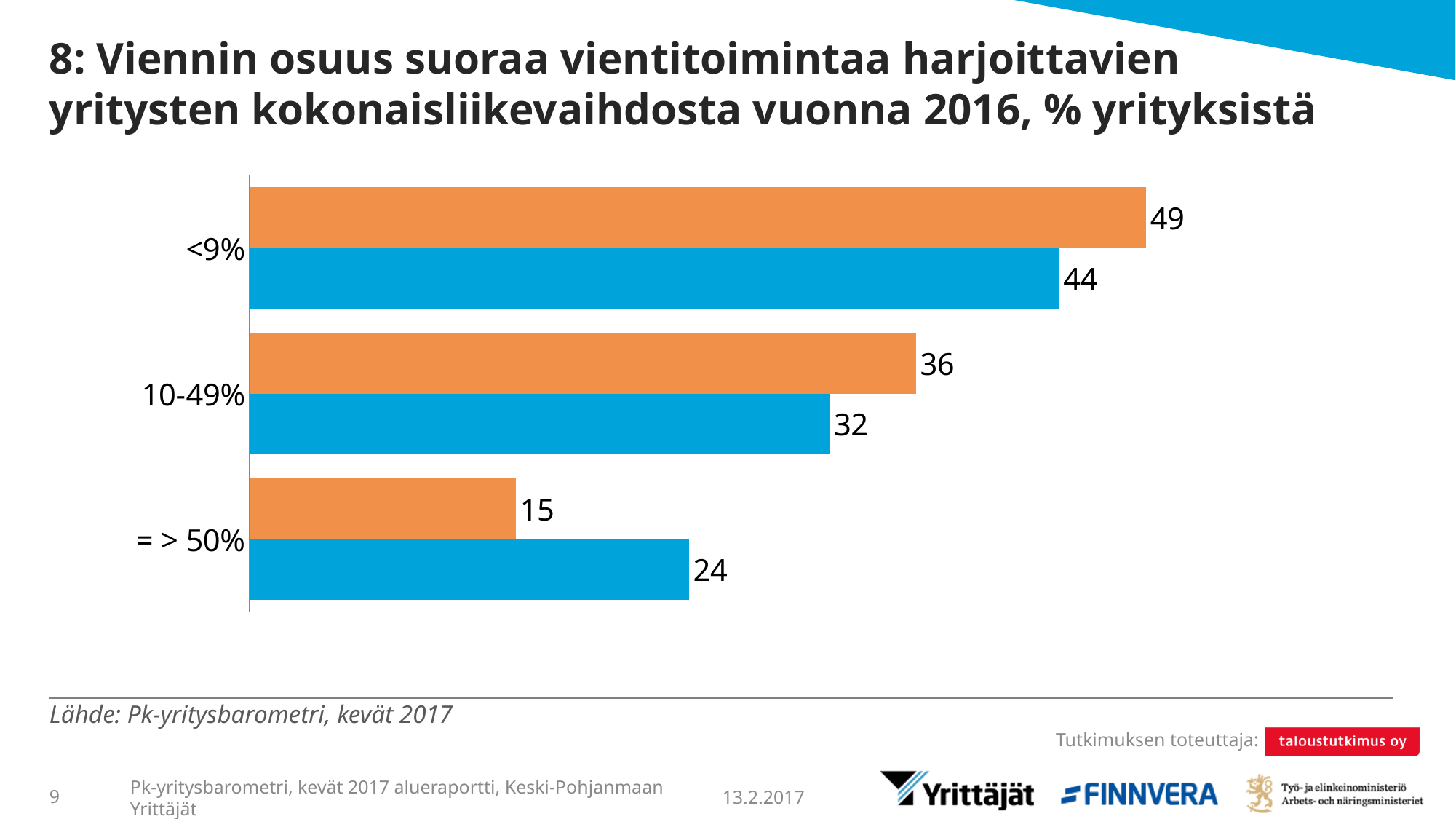
What is the value of the blue bar for the 10-49% category? 32 What is the difference between the orange and blue bar values for the <9% category? 5 What is the difference between the blue and orange bar values for the = > 50% category? 9 How many categories are shown on the chart? 3 Which category has the lowest blue bar value? = > 50% Which category has the highest orange bar value? <9% What is the value of the blue bar for the = > 50% category? 24 What source is cited below the chart? Pk-yritysbarometri, kevät 2017 What is the value of the orange bar for the = > 50% category? 15 What type of chart is shown on the slide? bar chart For the = > 50% category, which bar is larger, orange or blue? blue What is the value of the orange bar for the <9% category? 49